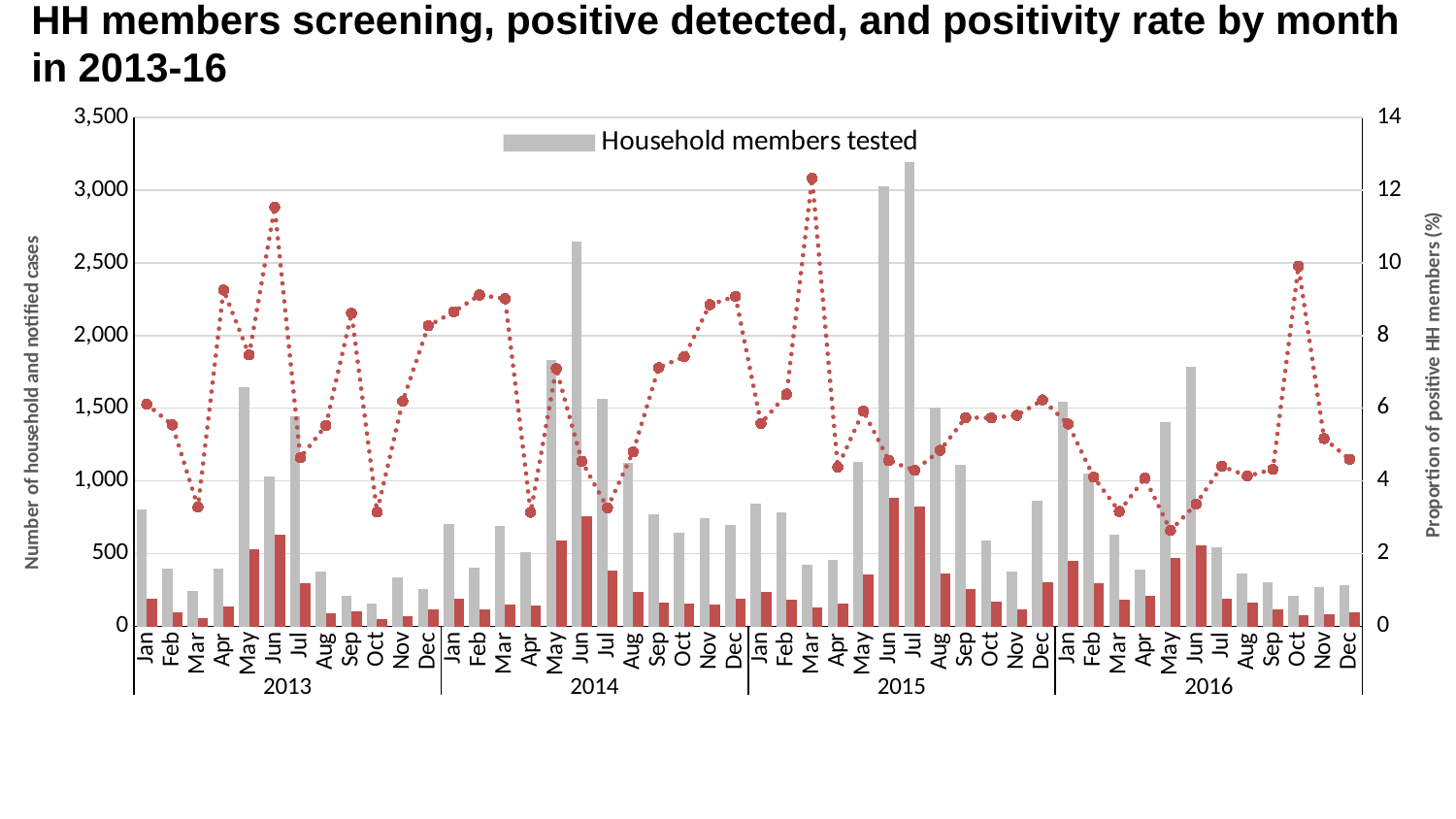
What is the only entry in the chart legend? Household members tested How many years are covered along the x axis? 4 Is the number of household members tested in Jun 2014 greater or less than 2,500? greater What is the title of the right-hand vertical axis? Proportion of positive HH members (%) What kind of chart is shown on the slide? A combination bar and line chart Is the number of household members tested in Jul 2015 greater or less than 3,000? greater In which month and year is the number of household members tested highest? Jul 2015 Is the positivity rate in Jun 2013 greater or less than 10%? greater How many series does the legend list? 1 In which month and year does the positivity rate line reach its highest point? Mar 2015 Which month had more household members tested, May 2014 or Jun 2014? Jun 2014